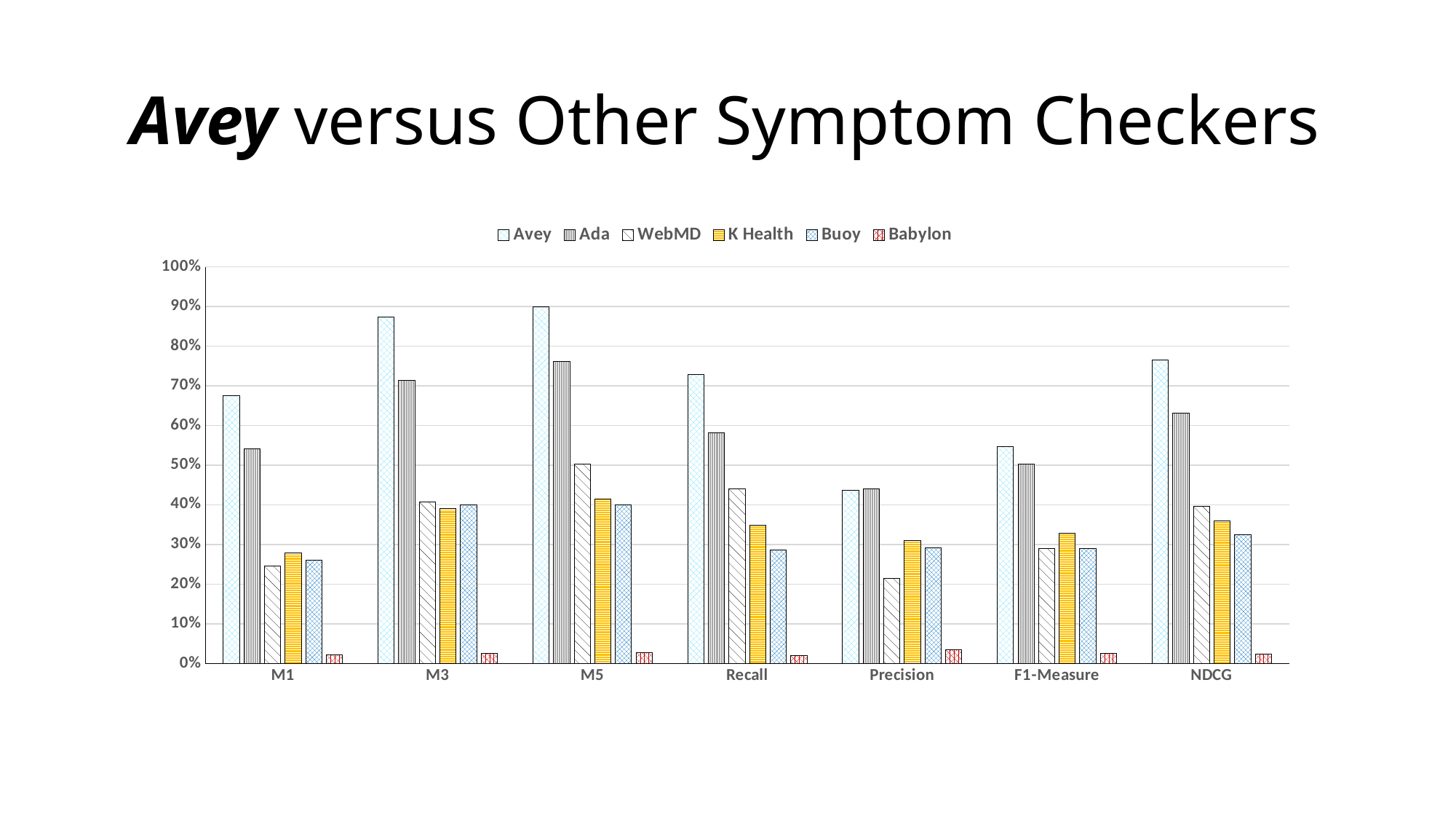
Is the value for WebMD in the M5 category greater or less than 40%? greater In the Recall category, which is larger: Ada or WebMD? Ada Is the value for Ada in the M1 category greater or less than 60%? less Is the value for Avey in the M5 category greater or less than 80%? greater What kind of chart is shown on the slide? bar chart How many categories are shown along the x axis? 7 Which series has the highest value in the M3 category? Avey In the F1-Measure category, which is larger: K Health or Buoy? K Health Which series has the lowest value in the Recall category? Babylon How many series does the legend list? 6 In which category does Ada reach its highest value? M5